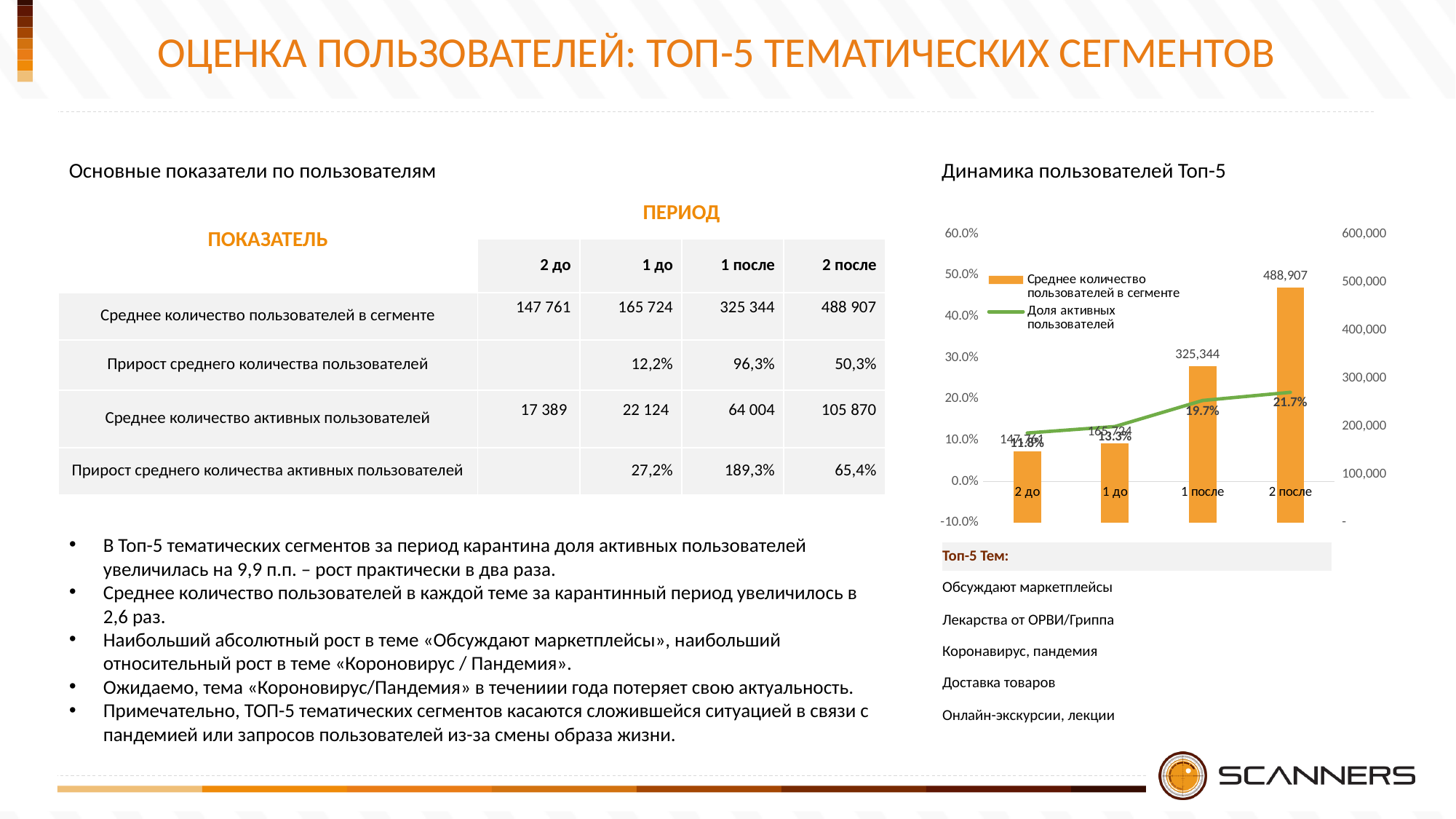
How many series does the legend of the chart 'Динамика пользователей Топ-5' list? 2 In the chart 'Динамика пользователей Топ-5', what is the average number of users in the segment for the period '1 после'? 325,344 In the chart 'Динамика пользователей Топ-5', what is the difference in average number of users between '2 после' and '1 после'? 163,563 In the chart 'Динамика пользователей Топ-5', does the share of active users rise or fall from '2 до' to '2 после'? rise In the chart 'Динамика пользователей Топ-5', what is the average number of users in the segment for the period '2 после'? 488,907 In the chart 'Динамика пользователей Топ-5', which is larger: the average number of users for '1 до' or for '1 после'? 1 после In the chart 'Динамика пользователей Топ-5', what is the share of active users for the period '2 после'? 21.7% What is the title of the chart on the right side of the slide? Динамика пользователей Топ-5 How many periods are shown on the x axis of the chart 'Динамика пользователей Топ-5'? 4 In the chart 'Динамика пользователей Топ-5', which period has the highest average number of users in the segment? 2 после In the chart 'Динамика пользователей Топ-5', what is the share of active users for the period '1 после'? 19.7% In the chart 'Динамика пользователей Топ-5', which period has the lowest share of active users? 2 до